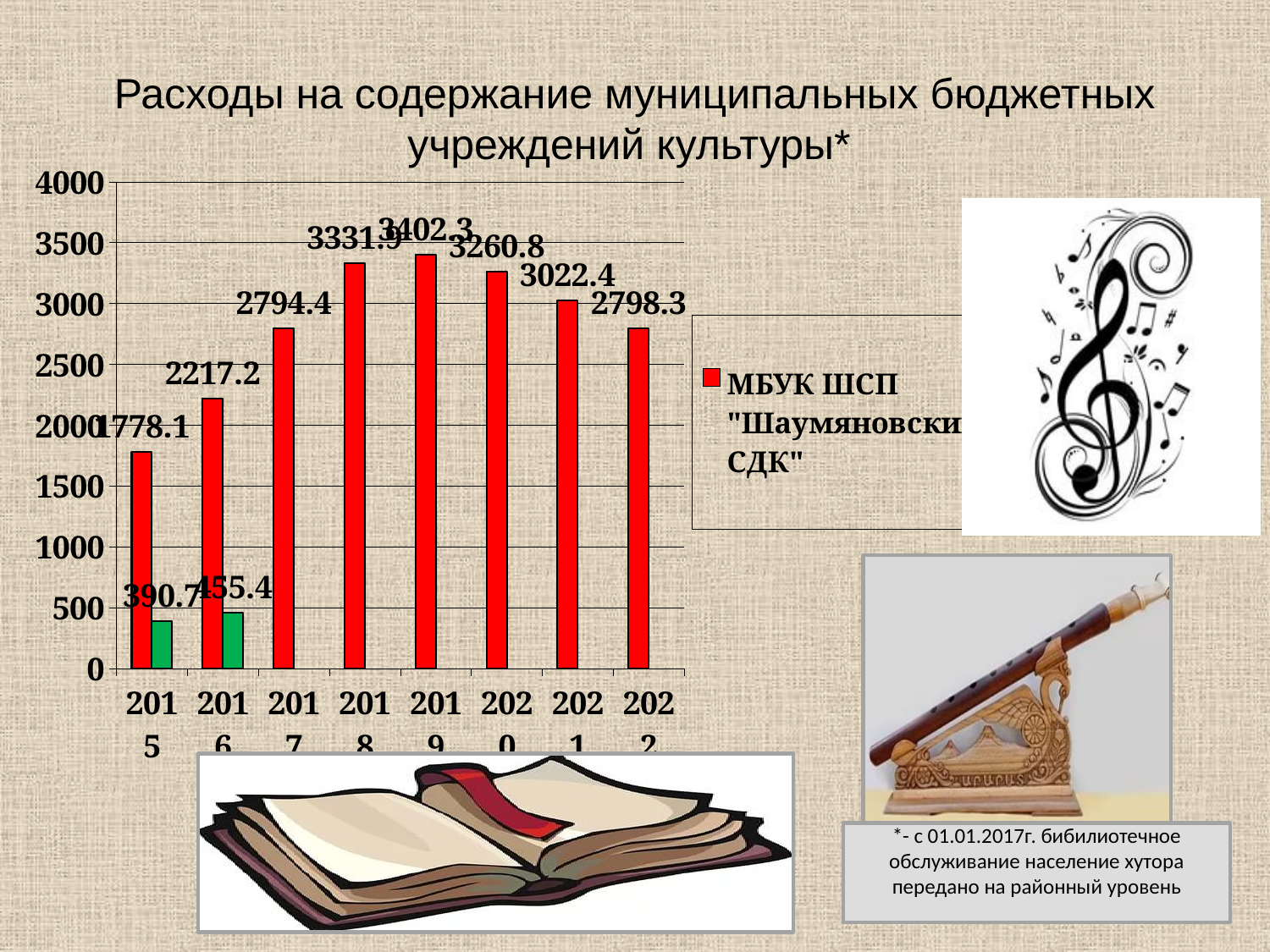
What is the value for 2019 for МБУК ШСП "Шаумяновский СДК"? 3402.3 Is the value for 2022 for МБУК ШСП "Шаумяновский СДК" greater or less than 3000? less In which year is the value for МБУК ШСП "Шаумяновский СДК" highest? 2019 What is the difference between the 2018 and 2017 values for МБУК ШСП "Шаумяновский СДК"? 537.5 What kind of chart is shown on the slide? bar chart In which year is the value for МБУК ШСП "Шаумяновский СДК" lowest? 2015 What is the value for 2015 for МБУК ШСП "Шаумяновский СДК"? 1778.1 How many years are shown on the x axis of the chart? 8 Which year has the larger value for МБУК ШСП "Шаумяновский СДК", 2020 or 2021? 2020 How many series does the legend list? 1 What is the value for 2022 for МБУК ШСП "Шаумяновский СДК"? 2798.3 Do the values for МБУК ШСП "Шаумяновский СДК" rise or fall from 2019 to 2022? fall